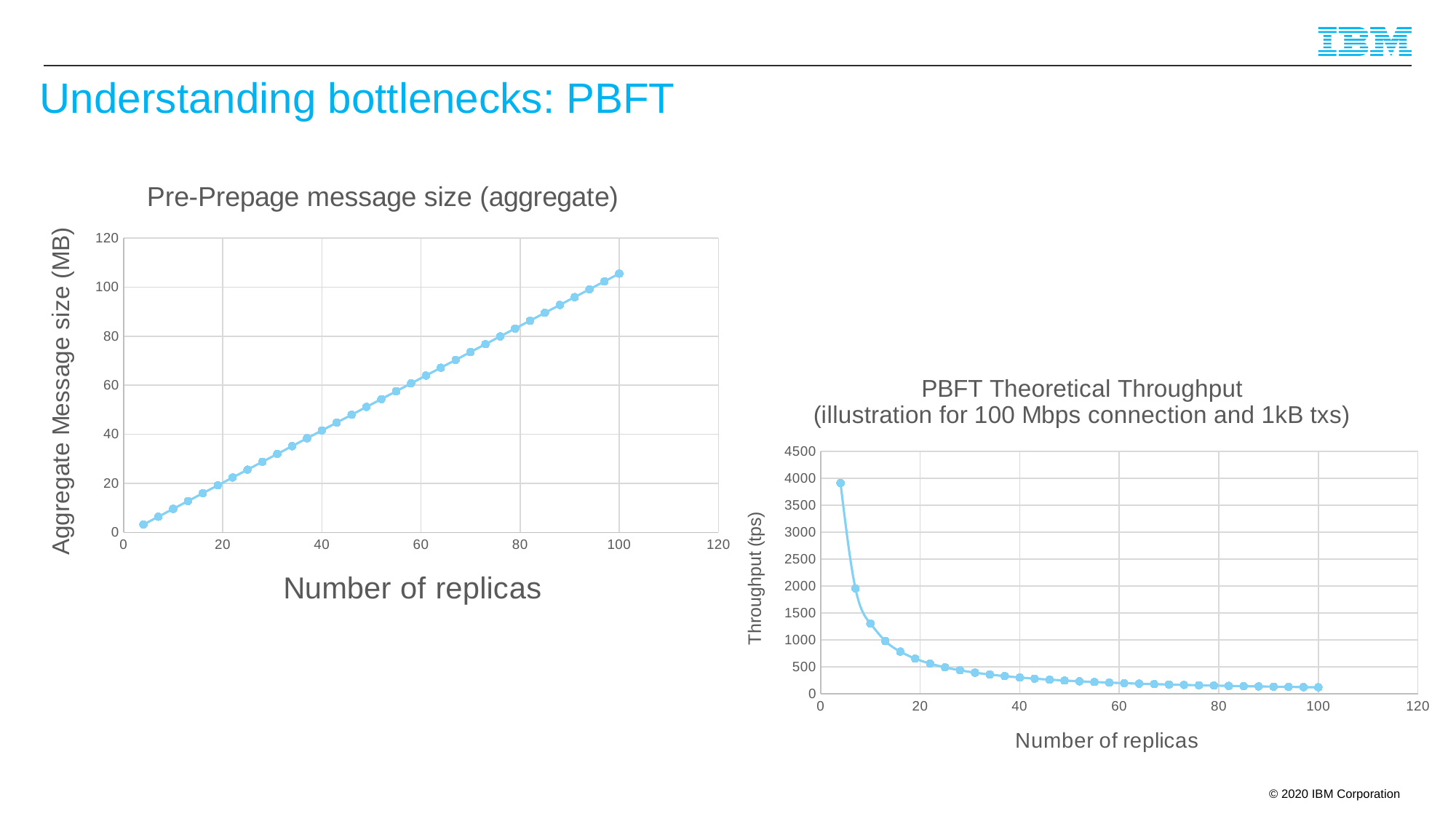
In the 'PBFT Theoretical Throughput' chart, is the throughput at the first plotted point (about 4 replicas) greater or less than 3500 tps? greater In the 'PBFT Theoretical Throughput' chart, does throughput rise or fall as the number of replicas increases? fall In the 'Pre-Prepage message size (aggregate)' chart, does the aggregate message size rise or fall as the number of replicas increases? rise In the 'PBFT Theoretical Throughput' chart, is the throughput at 20 replicas greater or less than 1000 tps? less What is the y-axis label of the 'PBFT Theoretical Throughput' chart? Throughput (tps) What kind of chart is the 'Pre-Prepage message size (aggregate)' chart on the left? line chart In the 'PBFT Theoretical Throughput' chart, is the throughput at 100 replicas greater or less than 500 tps? less What is the x-axis label of the 'Pre-Prepage message size (aggregate)' chart? Number of replicas In the 'Pre-Prepage message size (aggregate)' chart, which has the larger aggregate message size: 40 replicas or 80 replicas? 80 replicas What kind of chart is the 'PBFT Theoretical Throughput' chart on the right? line chart